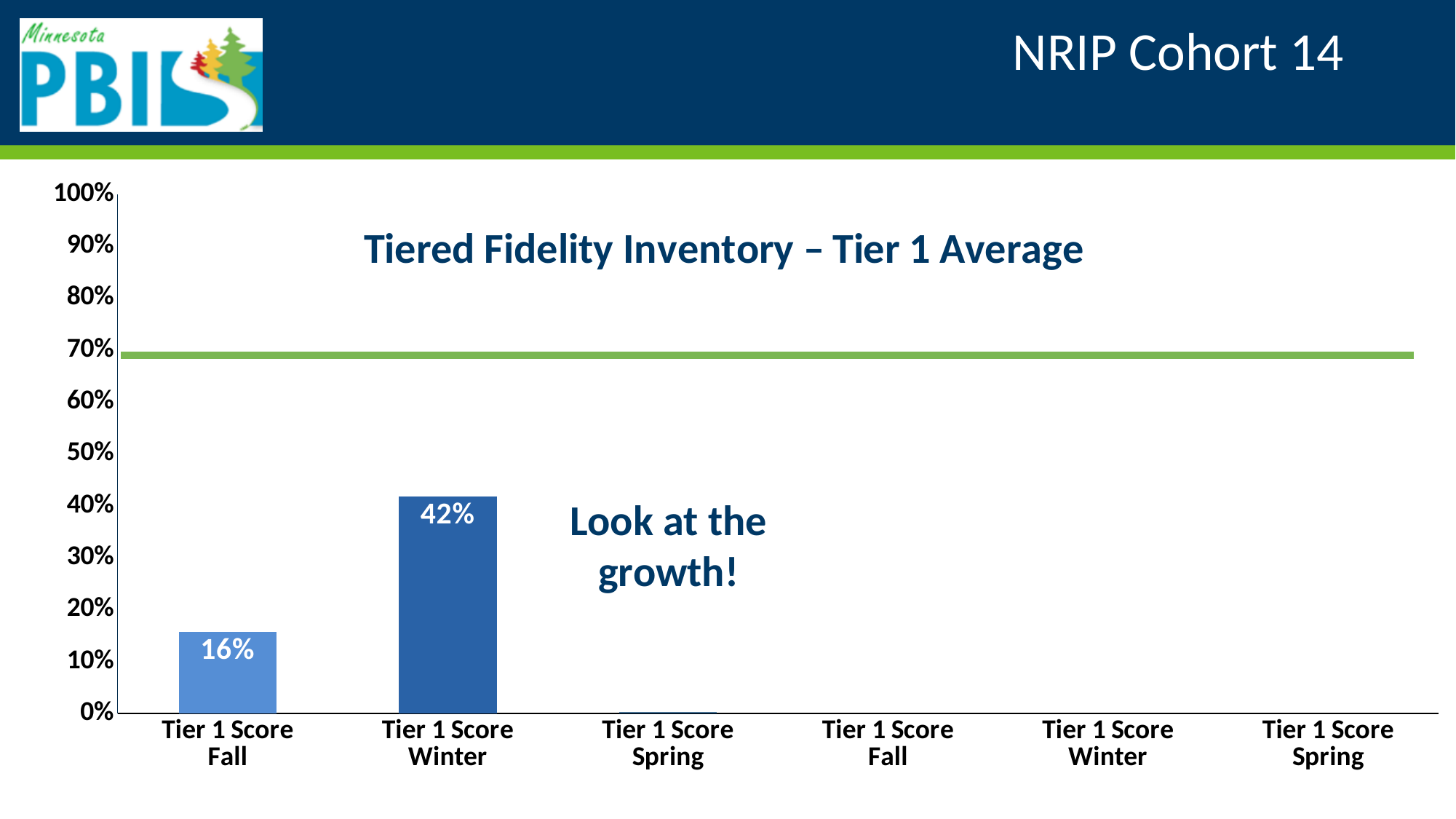
What is the difference between the Tier 1 Score Winter bar and the leftmost Tier 1 Score Fall bar? 26% What is the title of the chart? Tiered Fidelity Inventory – Tier 1 Average How many category labels are shown along the x axis? 6 What is the value of the leftmost bar, Tier 1 Score Fall? 16% Do the values rise or fall from the leftmost Tier 1 Score Fall bar to the Tier 1 Score Winter bar? rise What is the value of the Tier 1 Score Winter bar (second from the left)? 42% What kind of chart is shown on the slide? bar chart Is the value for the leftmost Tier 1 Score Fall bar greater or less than 20%? less Which category has the highest bar on the chart? Tier 1 Score Winter Which is larger, the leftmost Tier 1 Score Fall bar or the Tier 1 Score Winter bar? Tier 1 Score Winter How many bars with visible values are plotted on the chart? 2 Is the value for the Tier 1 Score Winter bar greater or less than 50%? less